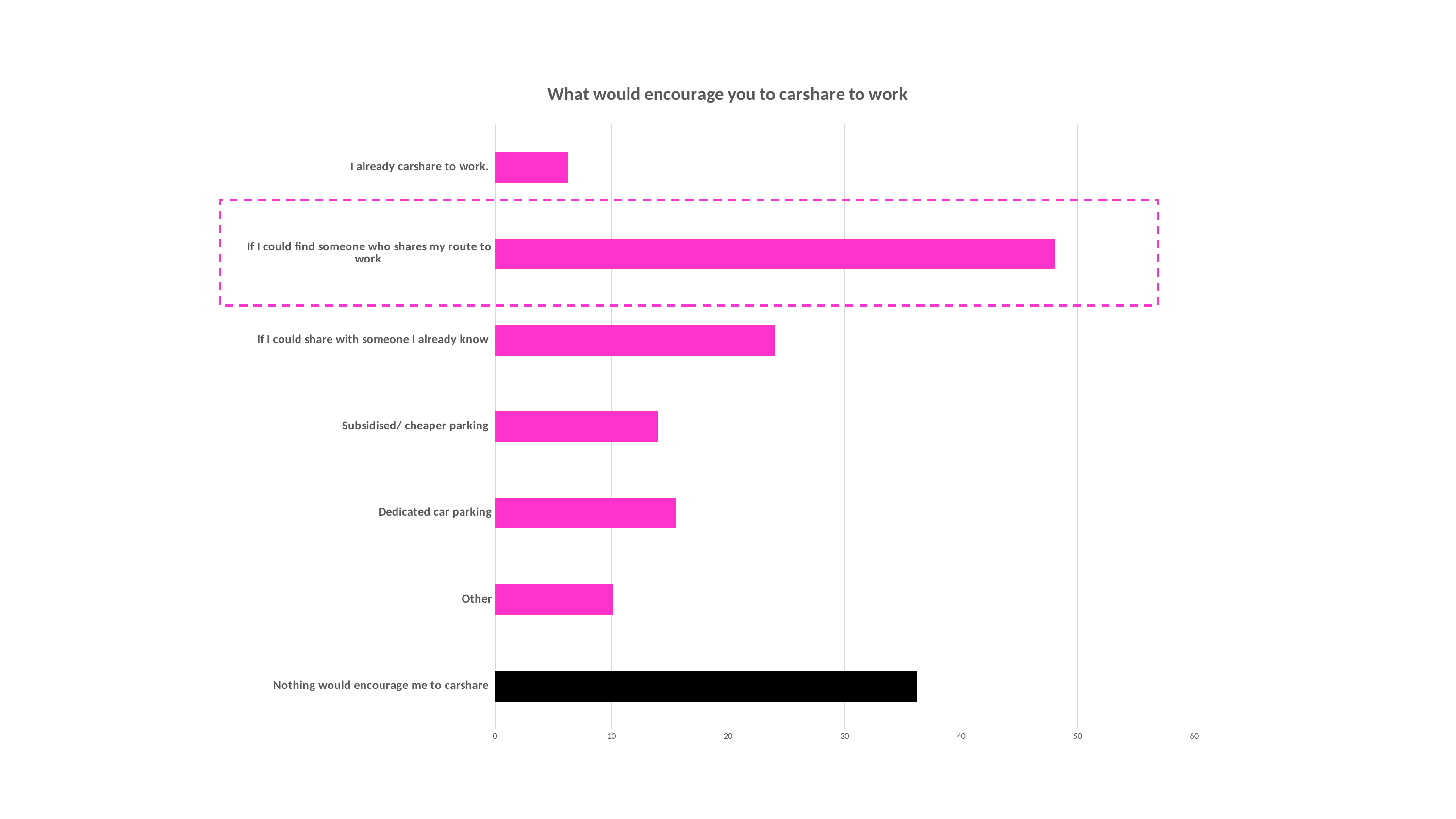
What kind of chart is shown on the slide? bar chart Is the value for "If I could find someone who shares my route to work" greater or less than 40? greater Which category has the lowest value? I already carshare to work. Which is larger: the value for "Nothing would encourage me to carshare" or the value for "If I could share with someone I already know"? Nothing would encourage me to carshare How many categories are plotted in the chart? 7 Is the value for "Nothing would encourage me to carshare" greater or less than 30? greater Which category's bar is coloured black rather than pink? Nothing would encourage me to carshare Is the value for "If I could share with someone I already know" greater or less than 20? greater Which category has the highest value? If I could find someone who shares my route to work What is the title of the chart? What would encourage you to carshare to work